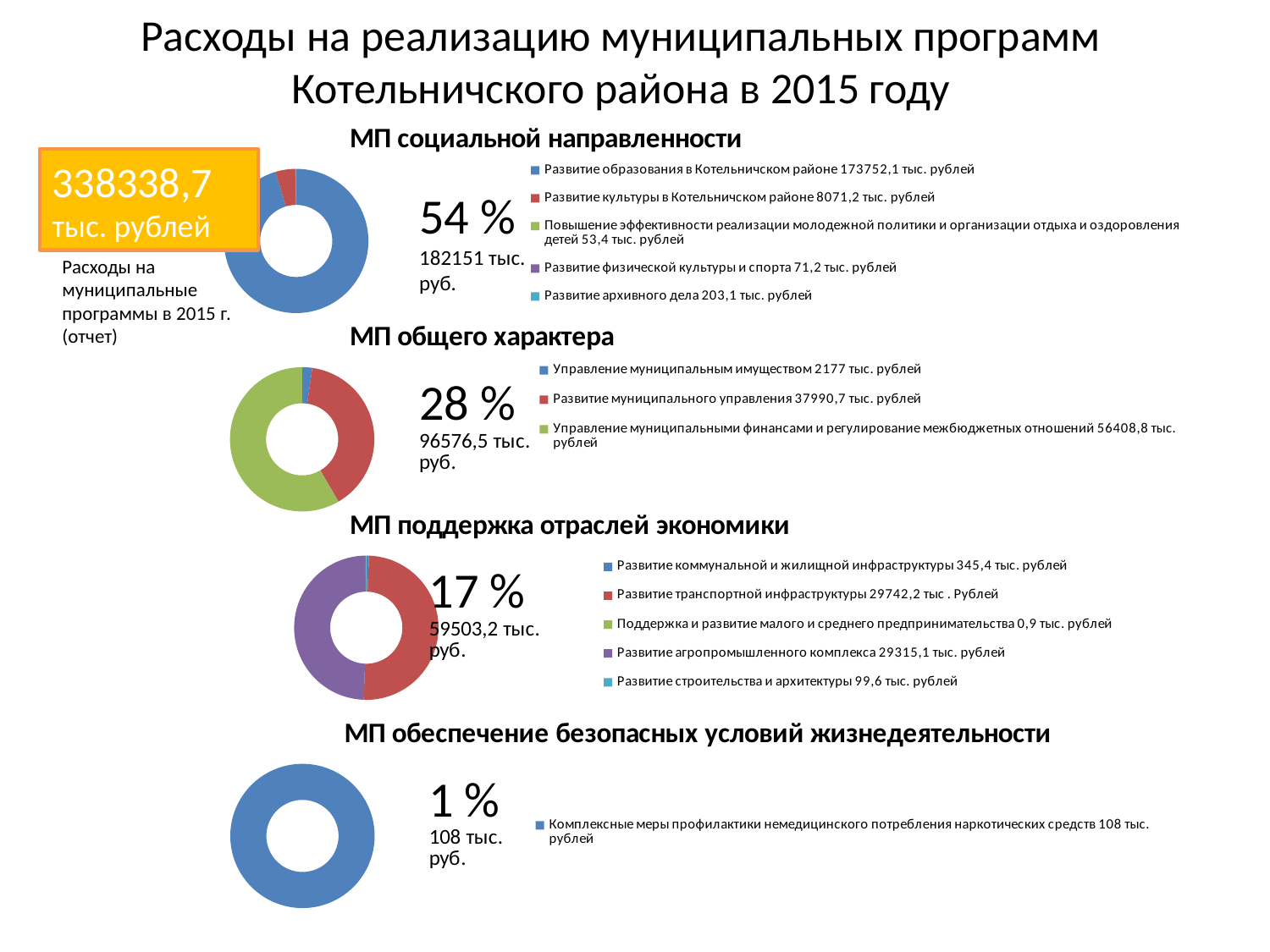
How many doughnut charts are on the slide? 4 What kind of chart is used for "МП социальной направленности"? doughnut chart In the "МП поддержка отраслей экономики" chart, what is the value for "Поддержка и развитие малого и среднего предпринимательства"? 0,9 тыс. рублей In the "МП социальной направленности" chart, how many entries does the legend list? 5 In the "МП социальной направленности" chart, what is the value for "Развитие образования в Котельничском районе"? 173752,1 тыс. рублей In the "МП общего характера" chart, which category has the largest value? Управление муниципальными финансами и регулирование межбюджетных отношений In the "МП общего характера" chart, what is the value for "Развитие муниципального управления"? 37990,7 тыс. рублей What total amount is shown next to the "МП поддержка отраслей экономики" chart? 59503,2 тыс. руб. In the "МП поддержка отраслей экономики" chart, which is larger: "Развитие транспортной инфраструктуры" or "Развитие агропромышленного комплекса"? Развитие транспортной инфраструктуры What percentage share is shown next to the "МП обеспечение безопасных условий жизнедеятельности" chart? 1 % In the "МП общего характера" chart, what is the difference between "Управление муниципальными финансами и регулирование межбюджетных отношений" and "Развитие муниципального управления"? 18418,1 тыс. рублей In the "МП социальной направленности" chart, which category has the smallest value? Повышение эффективности реализации молодежной политики и организации отдыха и оздоровления детей